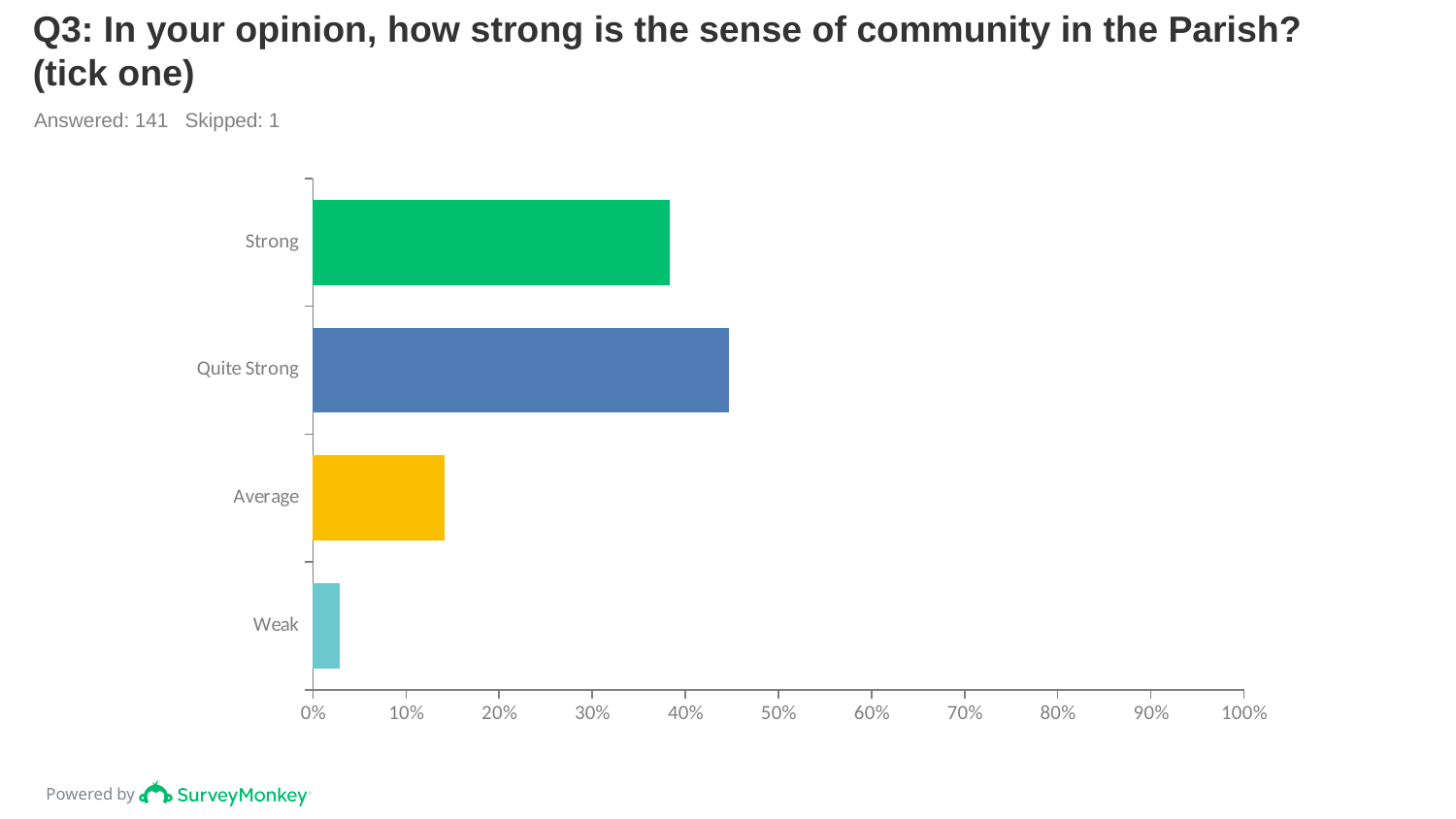
Is the value for Average greater or less than 20%? less Is the value for Strong greater or less than 30%? greater Which is larger, the value for Strong or the value for Average? Strong How many respondents answered this question according to the slide? 141 Which category has the lowest value? Weak Which category has the highest value? Quite Strong Is the value for Weak greater or less than 10%? less What kind of chart is shown on the slide? bar chart How many categories are shown in the chart? 4 Which is larger, the value for Quite Strong or the value for Strong? Quite Strong What is the maximum value shown on the x axis? 100%